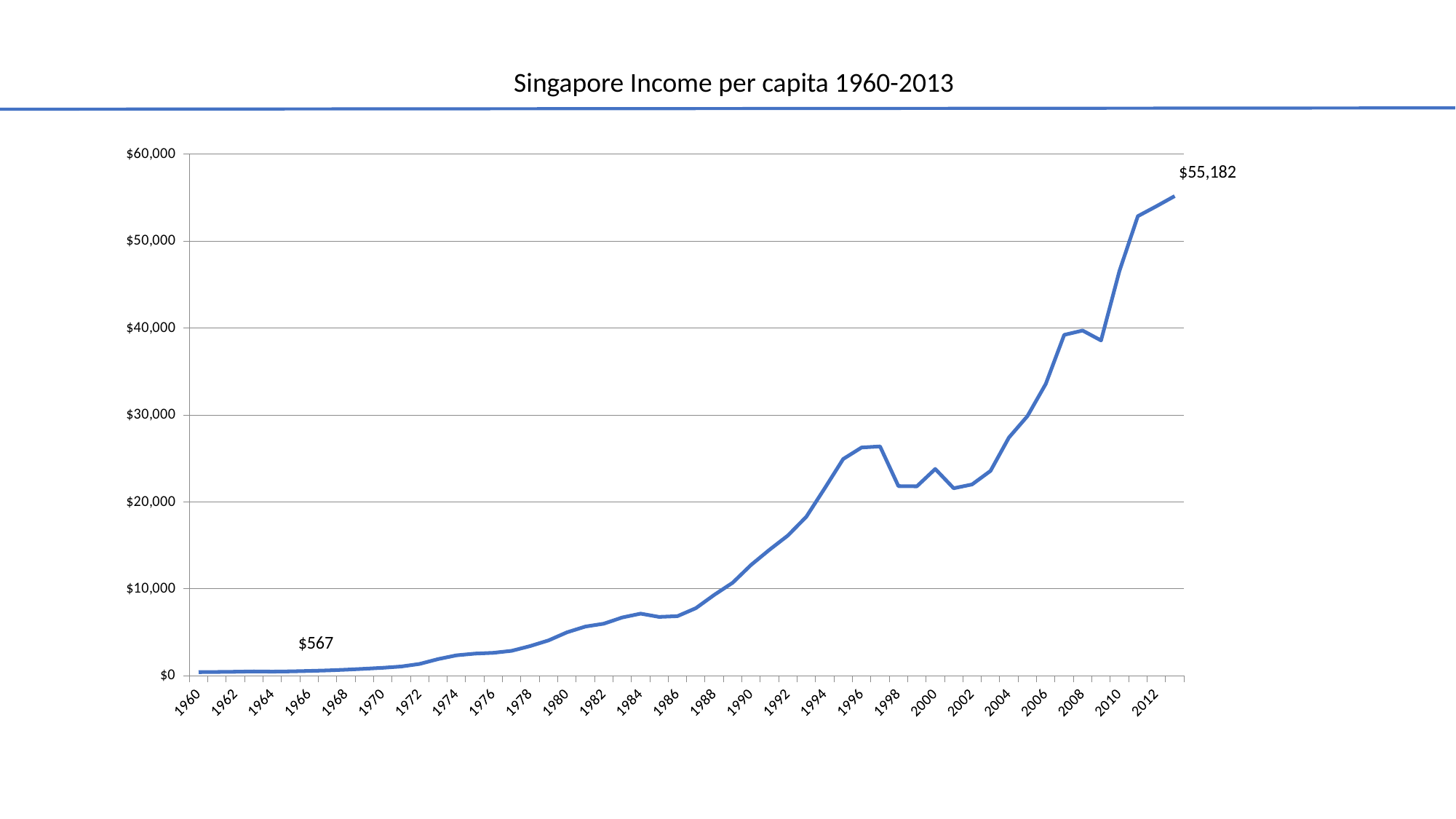
Which year has the highest income per capita? 2013 Is the value for 1996 greater or less than $20,000? greater What kind of chart is shown on the slide? line chart What is the title of the chart? Singapore Income per capita 1960-2013 Does income per capita generally rise or fall from 1960 to 2013? rise What is the income per capita value labelled at the end of the line, for 2013? $55,182 Is the value for 1980 greater or less than $10,000? less Is the value for 2002 greater or less than $30,000? less Which year has the larger income per capita, 1997 or 2002? 1997 Which year has the lowest income per capita? 1960